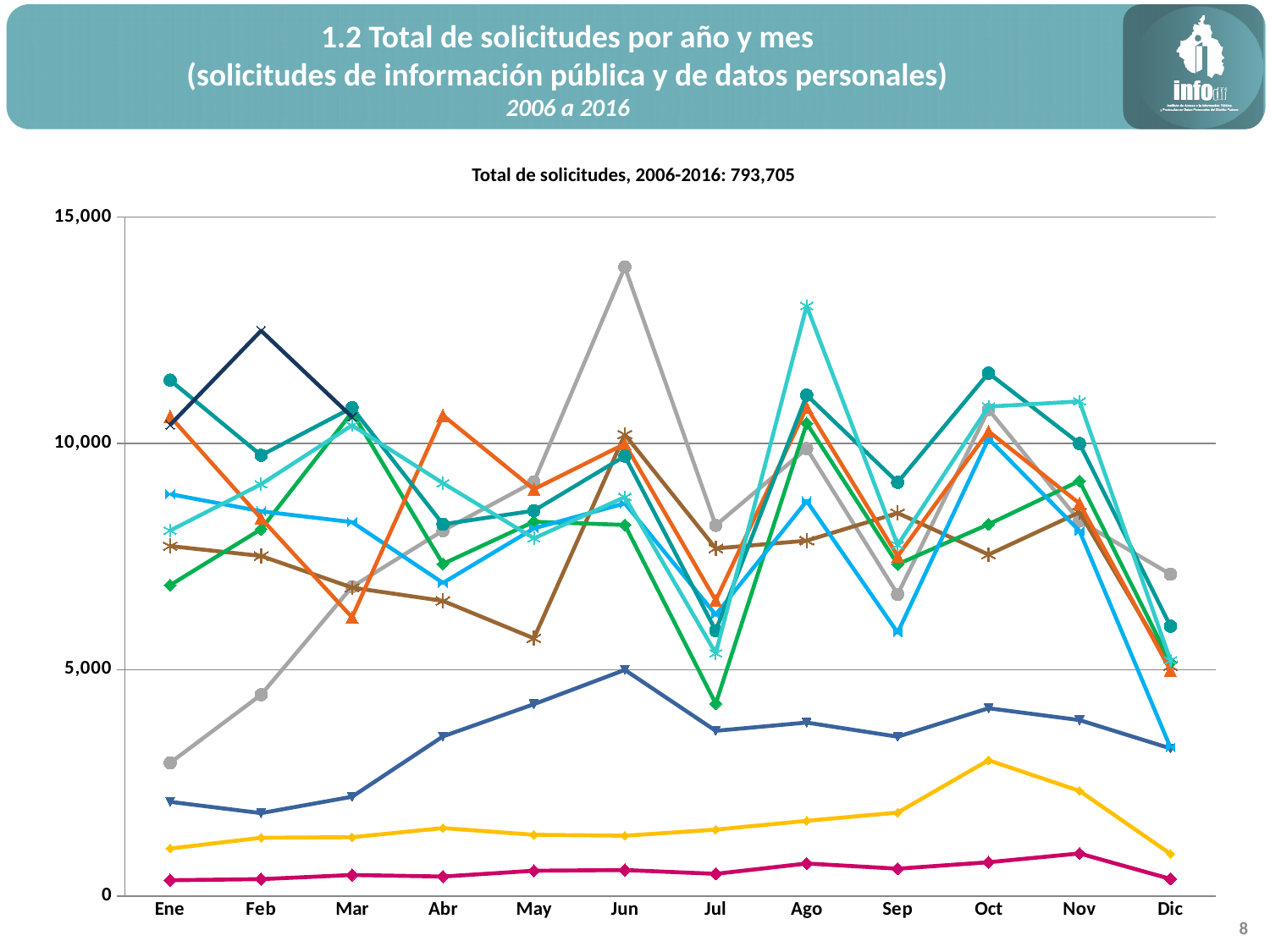
Is the value of the yellow line in Oct greater or less than 5,000? less What is the highest value shown on the y axis of the chart? 15,000 According to the chart title, what is the total number of solicitudes for 2006-2016? 793,705 Is the value of the dark navy line in Feb greater or less than 10,000? greater Is the value of the magenta line in Nov greater or less than 5,000? less Does the yellow line rise or fall from Oct to Dic? fall What is the title printed above the chart? Total de solicitudes, 2006-2016: 793,705 What kind of chart is shown on the slide? line chart How many months are shown along the x axis of the chart? 12 Does the grey line rise or fall from Ene to Jun? rise In which month does the highest point of any line on the chart occur? Jun